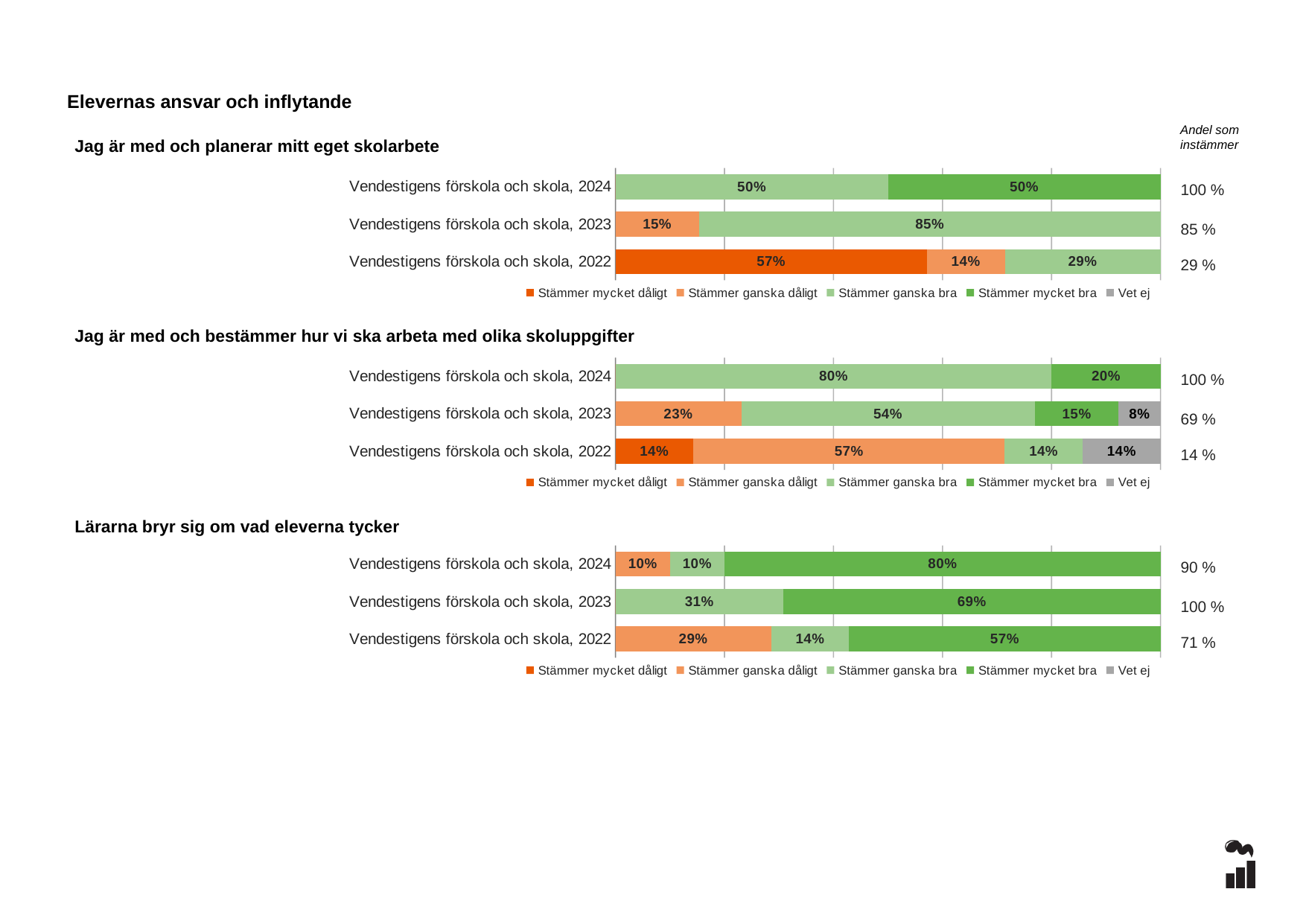
In the chart 'Lärarna bryr sig om vad eleverna tycker', which year has the highest 'Andel som instämmer'? 2023 What kind of chart is 'Jag är med och planerar mitt eget skolarbete'? Stacked bar chart In the chart 'Jag är med och bestämmer hur vi ska arbeta med olika skoluppgifter', what is the difference between the 'Stämmer ganska dåligt' values for 2022 and 2023? 34 percentage points How many series does the legend list for the chart 'Lärarna bryr sig om vad eleverna tycker'? 5 In the chart 'Jag är med och bestämmer hur vi ska arbeta med olika skoluppgifter', what is the value for 'Stämmer ganska bra' for Vendestigens förskola och skola, 2024? 80% In the chart 'Lärarna bryr sig om vad eleverna tycker', what is the value for 'Stämmer mycket bra' for Vendestigens förskola och skola, 2024? 80% In the chart 'Jag är med och planerar mitt eget skolarbete', what is the 'Andel som instämmer' for Vendestigens förskola och skola, 2023? 85 % In the chart 'Jag är med och planerar mitt eget skolarbete', what is the value for 'Stämmer mycket dåligt' for Vendestigens förskola och skola, 2022? 57% In the chart 'Jag är med och bestämmer hur vi ska arbeta med olika skoluppgifter', what is the value for 'Vet ej' for Vendestigens förskola och skola, 2023? 8% In the chart 'Lärarna bryr sig om vad eleverna tycker', which is larger: the 'Stämmer mycket bra' value for 2023 or for 2022? 2023 In the chart 'Jag är med och planerar mitt eget skolarbete', which year has the lowest 'Andel som instämmer'? 2022 In the chart 'Jag är med och bestämmer hur vi ska arbeta med olika skoluppgifter', does the 'Andel som instämmer' rise or fall from 2022 to 2024? rise